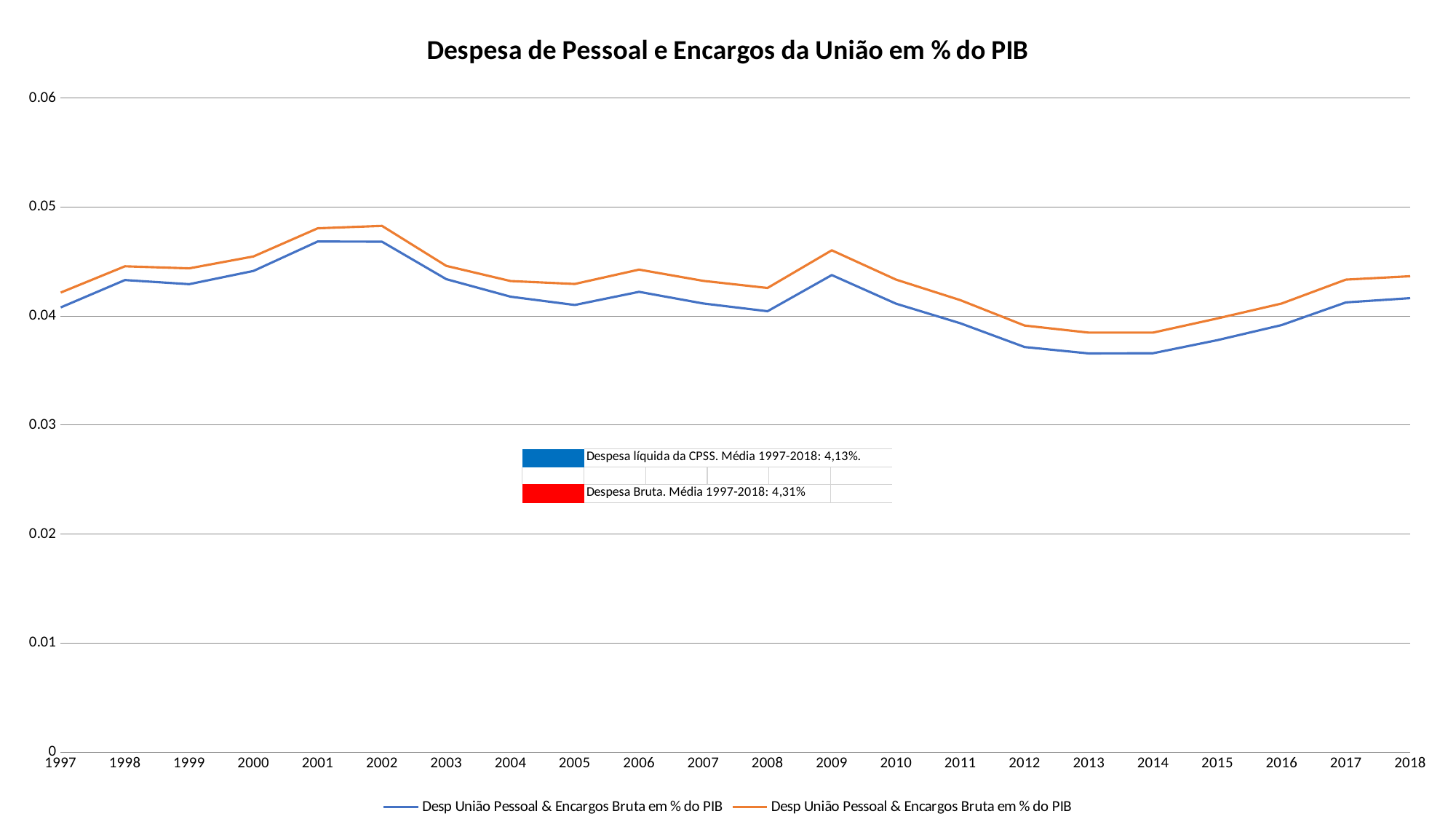
Is the value of the blue line in 2009 greater or less than 0.04? greater Is the value of the blue line in 2013 greater or less than 0.04? less How many series does the legend list? 2 Which line is higher in 2010, the blue line or the orange line? the orange line What is the title of the chart? Despesa de Pessoal e Encargos da União em % do PIB For the blue line, which year has the larger value, 2002 or 2013? 2002 How many years are plotted along the x axis? 22 According to the text box on the chart, what is the 1997-2018 average of the Despesa Bruta series? 4,31% What kind of chart is shown on the slide? line chart Do the values of the orange line rise or fall from 2009 to 2013? fall Is the value of the orange line in 2002 greater or less than 0.04? greater